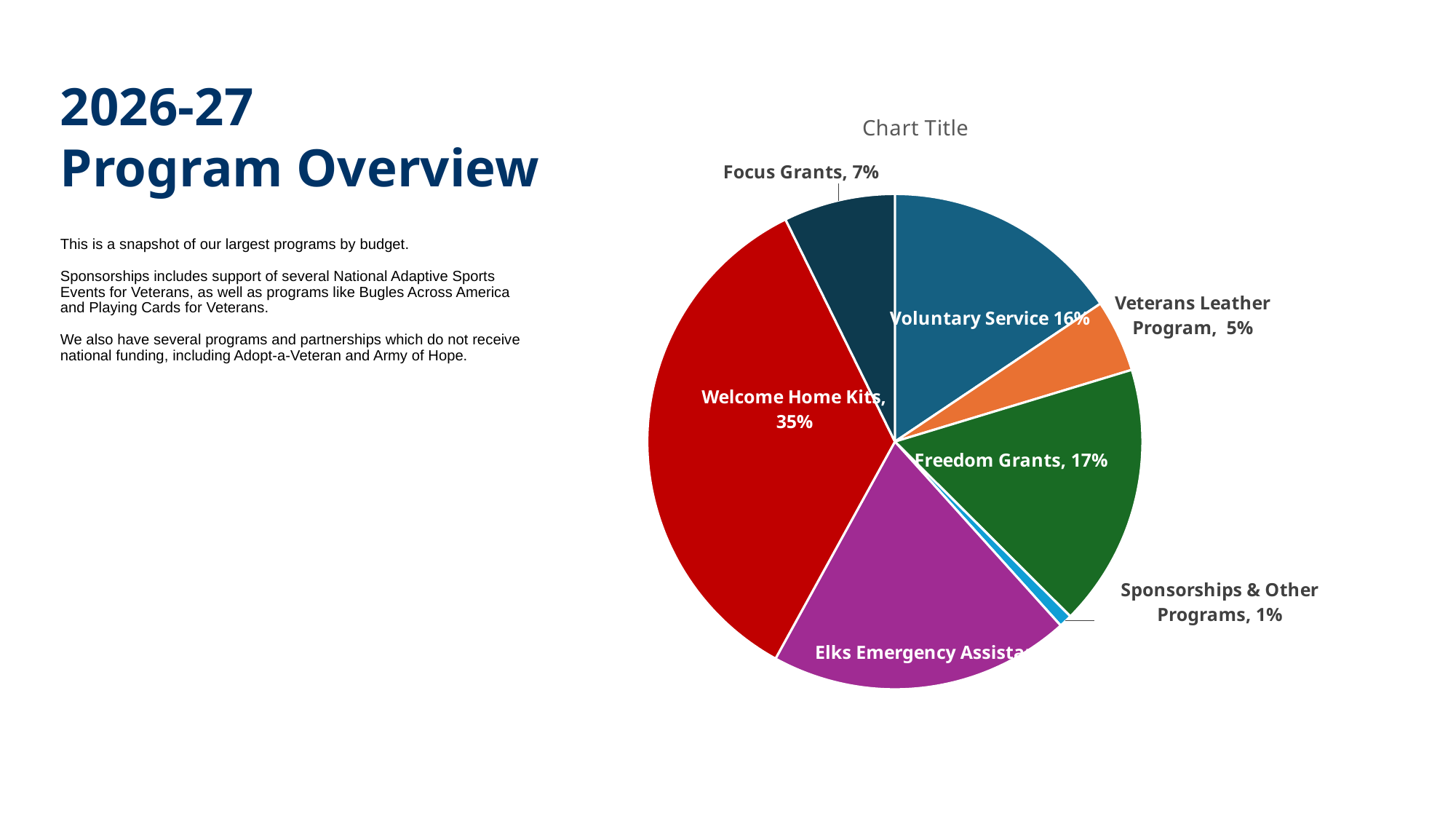
Which program has the smallest slice of the pie? Sponsorships & Other Programs What kind of chart is shown on the slide? Pie chart What is the value shown for Focus Grants? 7% What is the value shown for Sponsorships & Other Programs? 1% What is the title shown above the pie chart? Chart Title Which program has the largest slice of the pie? Welcome Home Kits What share of the pie does Welcome Home Kits represent? 35% What is the value shown for Voluntary Service? 16% How many slices does the pie chart have? 7 What is the value shown for Freedom Grants? 17% What is the difference in percentage points between Welcome Home Kits and Focus Grants? 28 percentage points What is the value shown for Veterans Leather Program? 5%